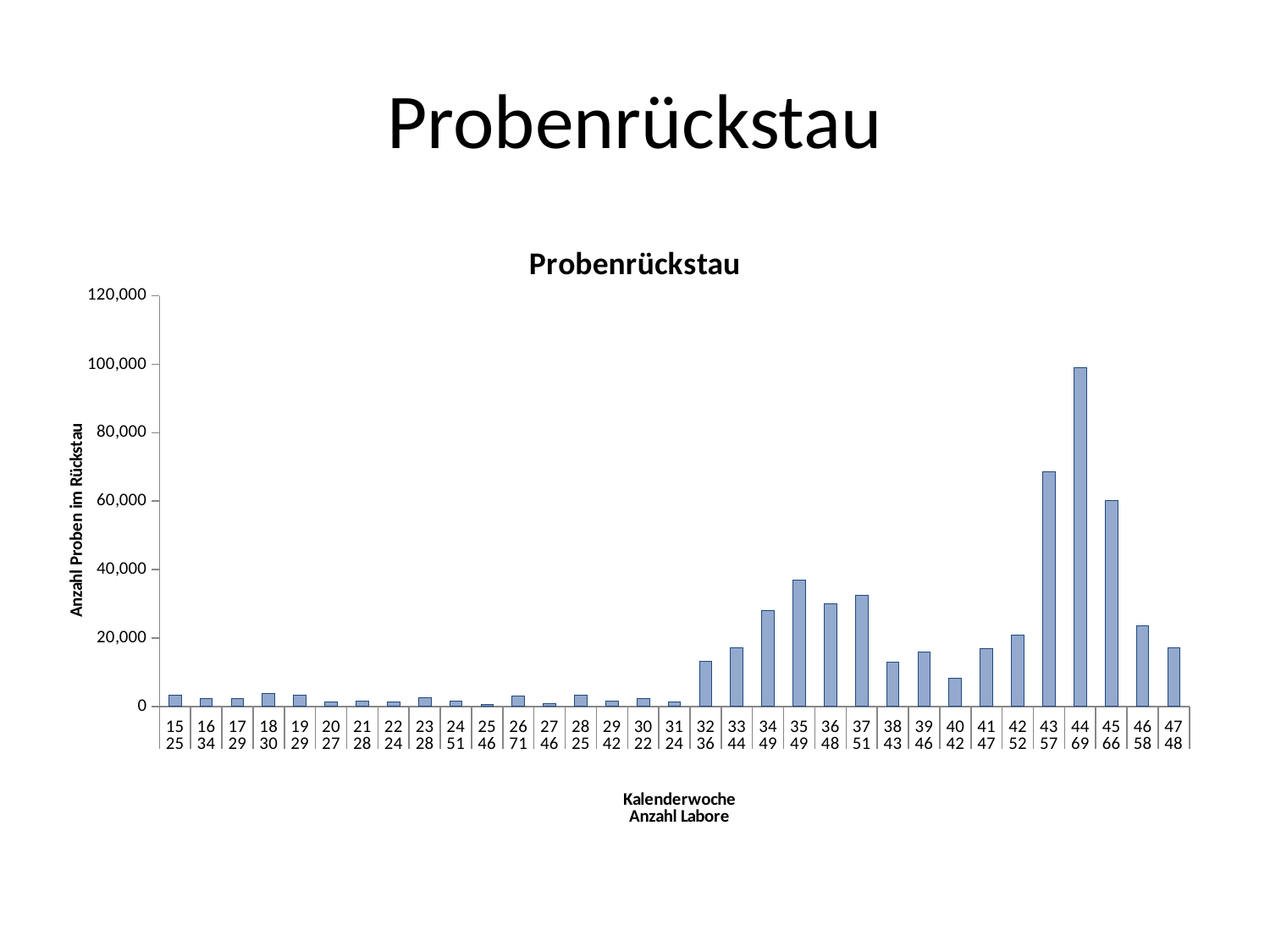
How many calendar weeks are plotted on the x axis? 33 How many laboratories (Anzahl Labore) are listed for calendar week 44? 69 Is the value for calendar week 44 greater or less than 80,000? greater Do the values rise or fall from calendar week 41 to calendar week 44? rise What kind of chart is shown on the slide? bar chart Which has the larger backlog, calendar week 43 or calendar week 45? 43 Is the value for calendar week 32 greater or less than 20,000? less Is the value for calendar week 43 greater or less than 60,000? greater What is the title of the y axis? Anzahl Proben im Rückstau Which calendar week (Kalenderwoche) has the highest number of samples in the backlog? 44